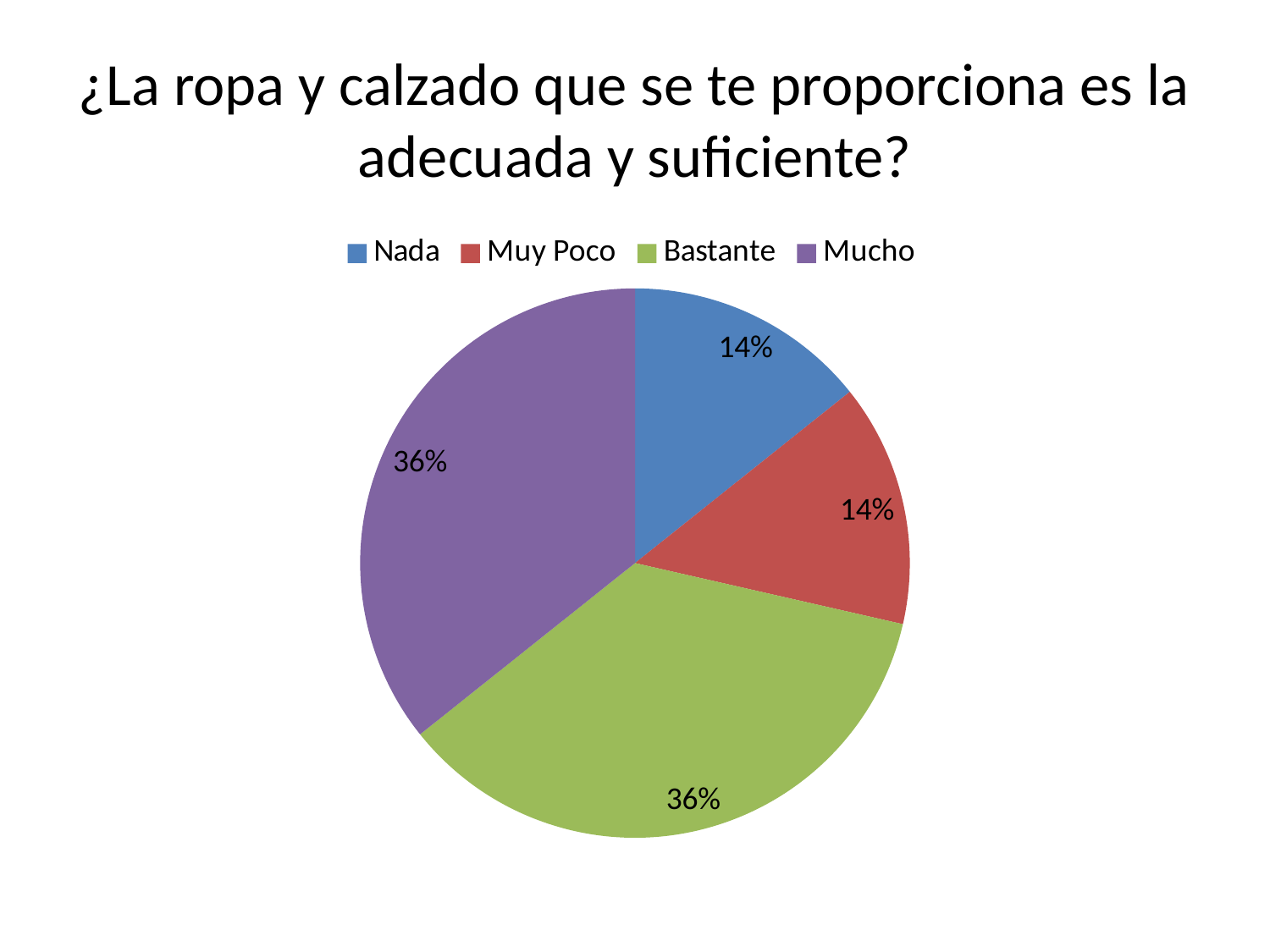
What kind of chart is shown on the slide? Pie chart Which category is shown in purple in the legend? Mucho What share of the pie does Mucho represent? 36% What share of the pie does Bastante represent? 36% What is the title of the chart? ¿La ropa y calzado que se te proporciona es la adecuada y suficiente? Which is larger, the share for Bastante or the share for Nada? Bastante Which is larger, the share for Muy Poco or the share for Mucho? Mucho What share of the pie does Nada represent? 14% What is the difference between the share for Mucho and the share for Nada? 22% How many categories does the pie chart show? 4 What is the difference between the share for Bastante and the share for Muy Poco? 22%